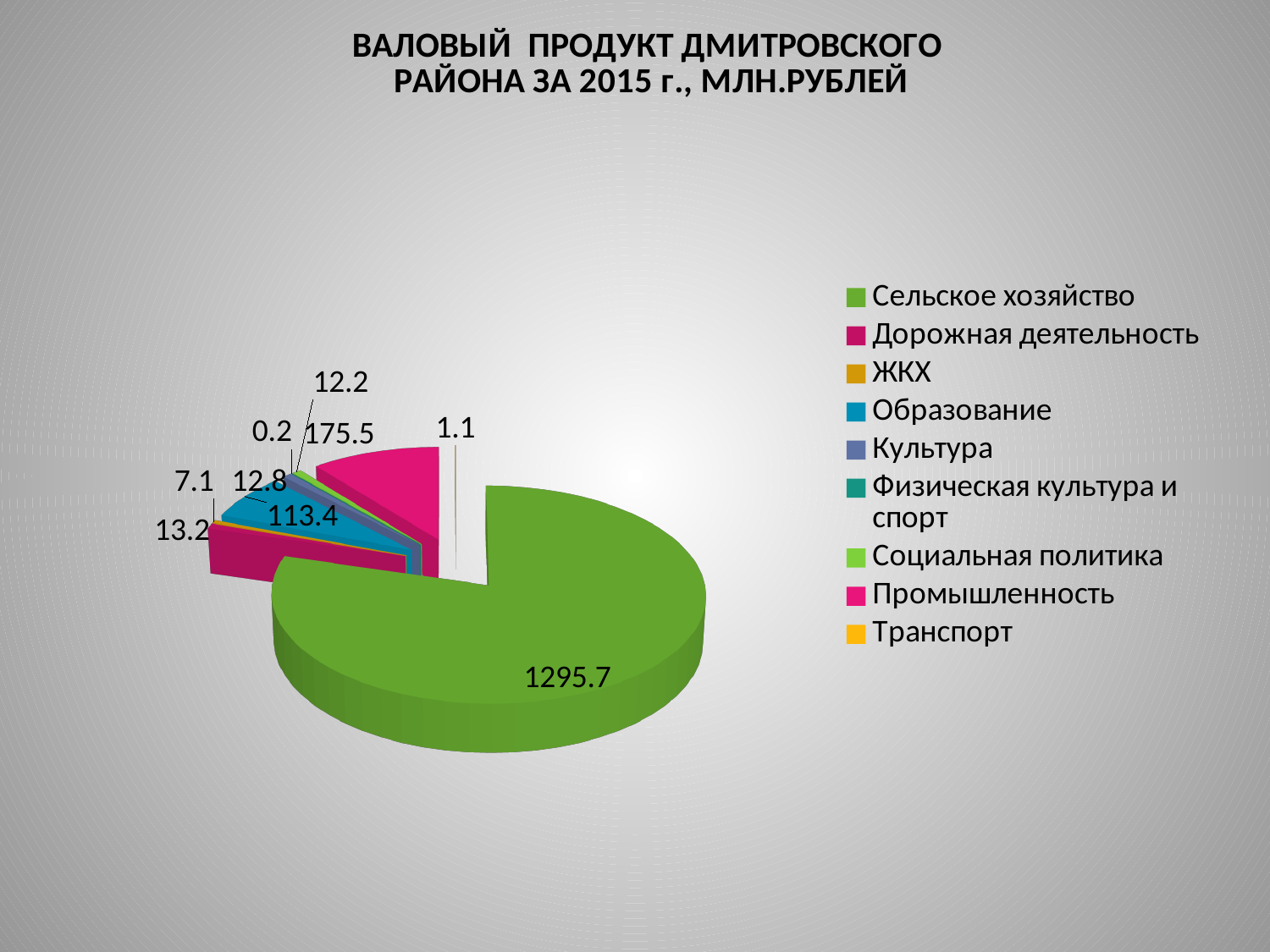
What is the value for Дорожная деятельность? 13.2 How many categories does the legend list? 9 What colour is the slice for Сельское хозяйство? green What is the value for Промышленность? 175.5 Which is larger, the value for Промышленность or the value for Дорожная деятельность? Промышленность What is the title of the chart? ВАЛОВЫЙ ПРОДУКТ ДМИТРОВСКОГО РАЙОНА ЗА 2015 г., МЛН.РУБЛЕЙ What is the difference between the values for Сельское хозяйство and Промышленность? 1120.2 What type of chart is shown on the slide? pie chart What is the difference between the values for Промышленность and Дорожная деятельность? 162.3 What is the value for Сельское хозяйство? 1295.7 What is the smallest value labelled on the pie chart? 0.2 Which category has the largest slice of the pie? Сельское хозяйство